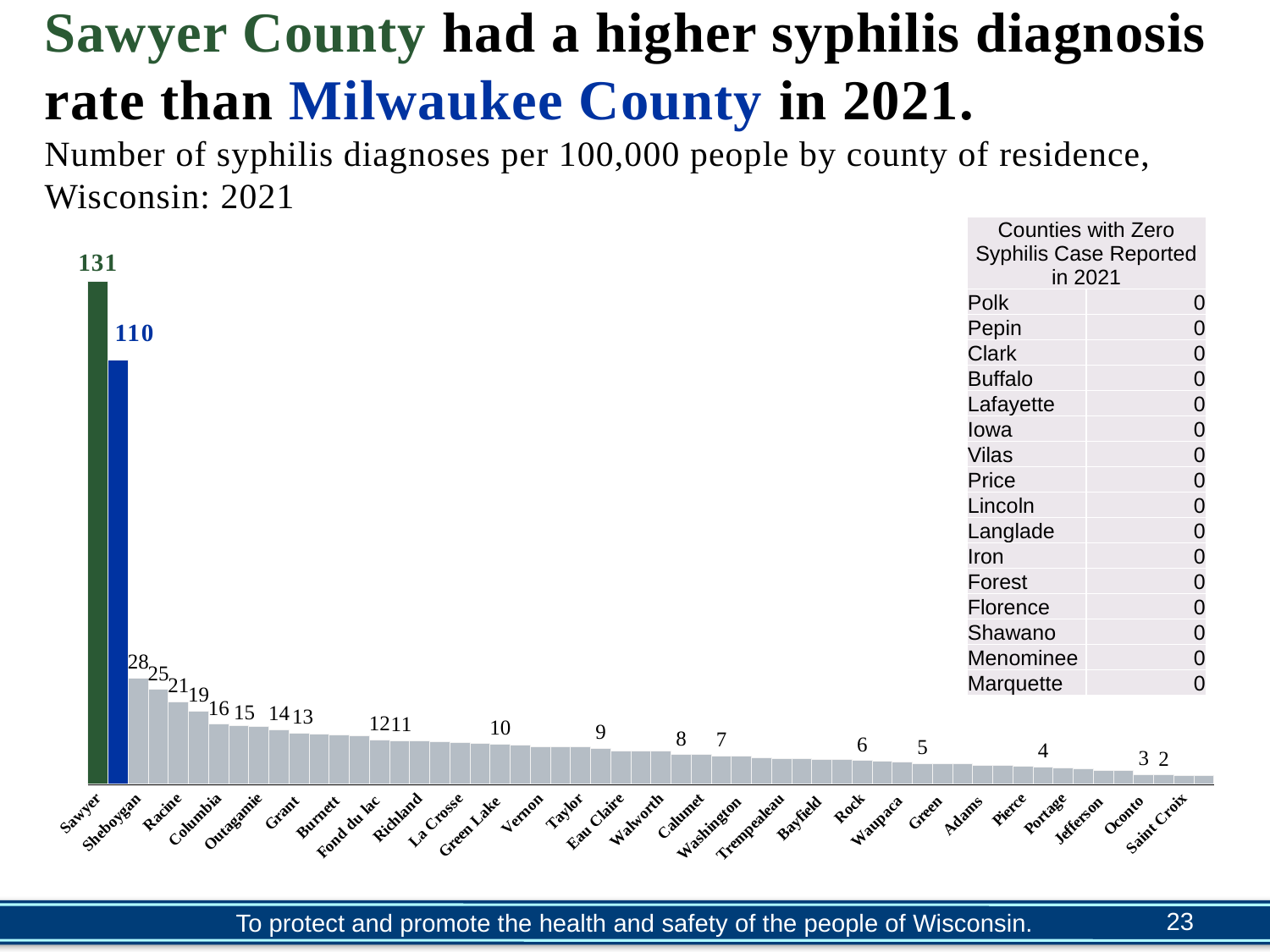
What colour is the bar for Milwaukee County? Blue What value is labeled on the bar for Sheboygan County? 28 Which has a higher syphilis diagnosis rate, Sawyer County or Milwaukee County? Sawyer County What is the syphilis diagnosis rate per 100,000 shown for Sawyer County? 131 Which has a higher rate, Milwaukee County or Sheboygan County? Milwaukee County How many counties are listed in the table of counties with zero syphilis cases reported in 2021? 16 Do the bar values rise or fall moving from left to right along the x axis? Fall What type of chart is used to show the syphilis diagnosis rates by county? Bar chart What is the difference between the rates for Sawyer County and Milwaukee County? 21 What is the syphilis diagnosis rate per 100,000 shown for Milwaukee County (the blue bar)? 110 What colour is the bar for Sawyer County? Green Which county has the highest syphilis diagnosis rate in the chart? Sawyer